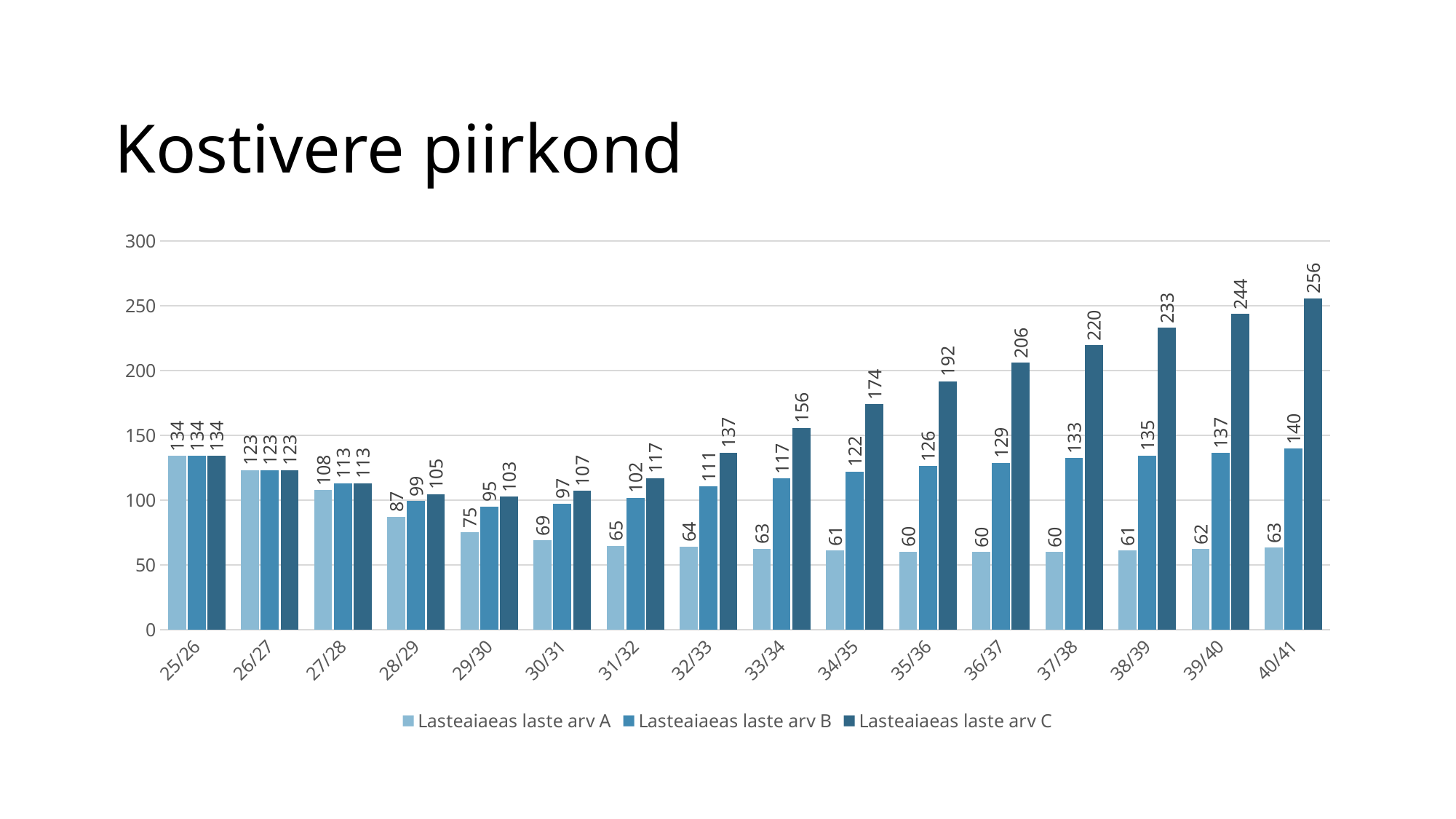
Does Lasteaiaeas laste arv C rise or fall from 27/28 to 40/41? rise What is the value of Lasteaiaeas laste arv A for 28/29? 87 Which is larger for 31/32: Lasteaiaeas laste arv B or Lasteaiaeas laste arv C? Lasteaiaeas laste arv C Is the value of Lasteaiaeas laste arv C for 37/38 greater or less than 200? greater Which category has the highest value for Lasteaiaeas laste arv C? 40/41 Which category has the lowest value for Lasteaiaeas laste arv A? 35/36, 36/37 and 37/38 (all 60) What is the value of Lasteaiaeas laste arv C for 40/41? 256 How many categories are shown on the x axis? 16 What kind of chart is shown on the slide? bar chart What is the difference between Lasteaiaeas laste arv C and Lasteaiaeas laste arv A for 40/41? 193 What is the value of Lasteaiaeas laste arv B for 34/35? 122 How many series does the legend list? 3